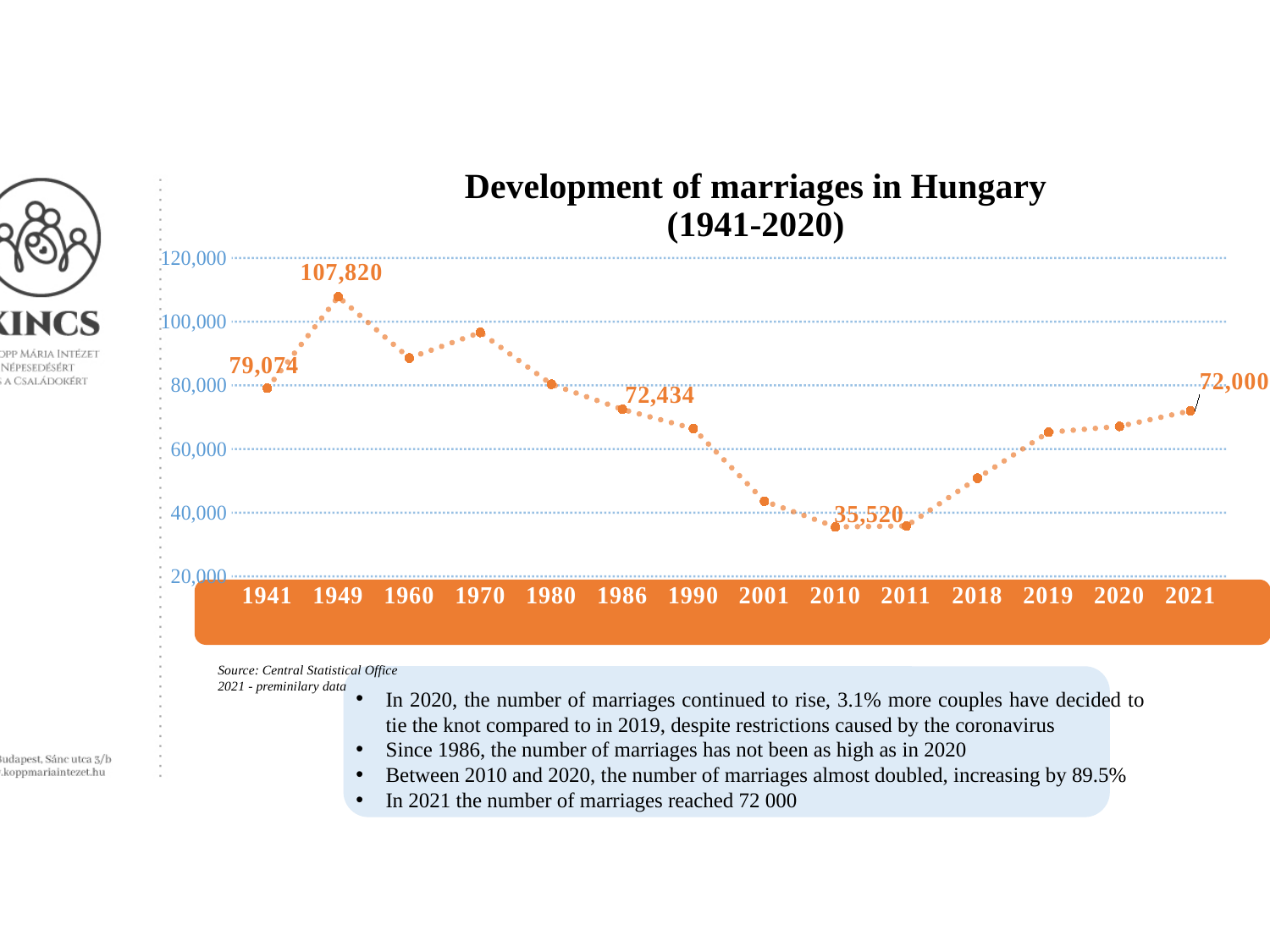
What is the number of marriages shown for 2010? 35,520 What is the difference between the number of marriages in 1986 and in 2010? 36,914 How many years are plotted on the x axis of the chart? 14 Is the value for 1970 greater or less than 100,000? less What is the number of marriages shown for 1949? 107,820 What is the title of the chart? Development of marriages in Hungary (1941-2020) Which year has more marriages, 1941 or 2021? 1941 Which year has the highest number of marriages in the chart? 1949 What is the number of marriages shown for 1986? 72,434 What is the difference between the number of marriages in 1949 and in 1941? 28,746 Does the number of marriages rise or fall between 2010 and 2021? Rise What type of chart is shown on the slide? Line chart